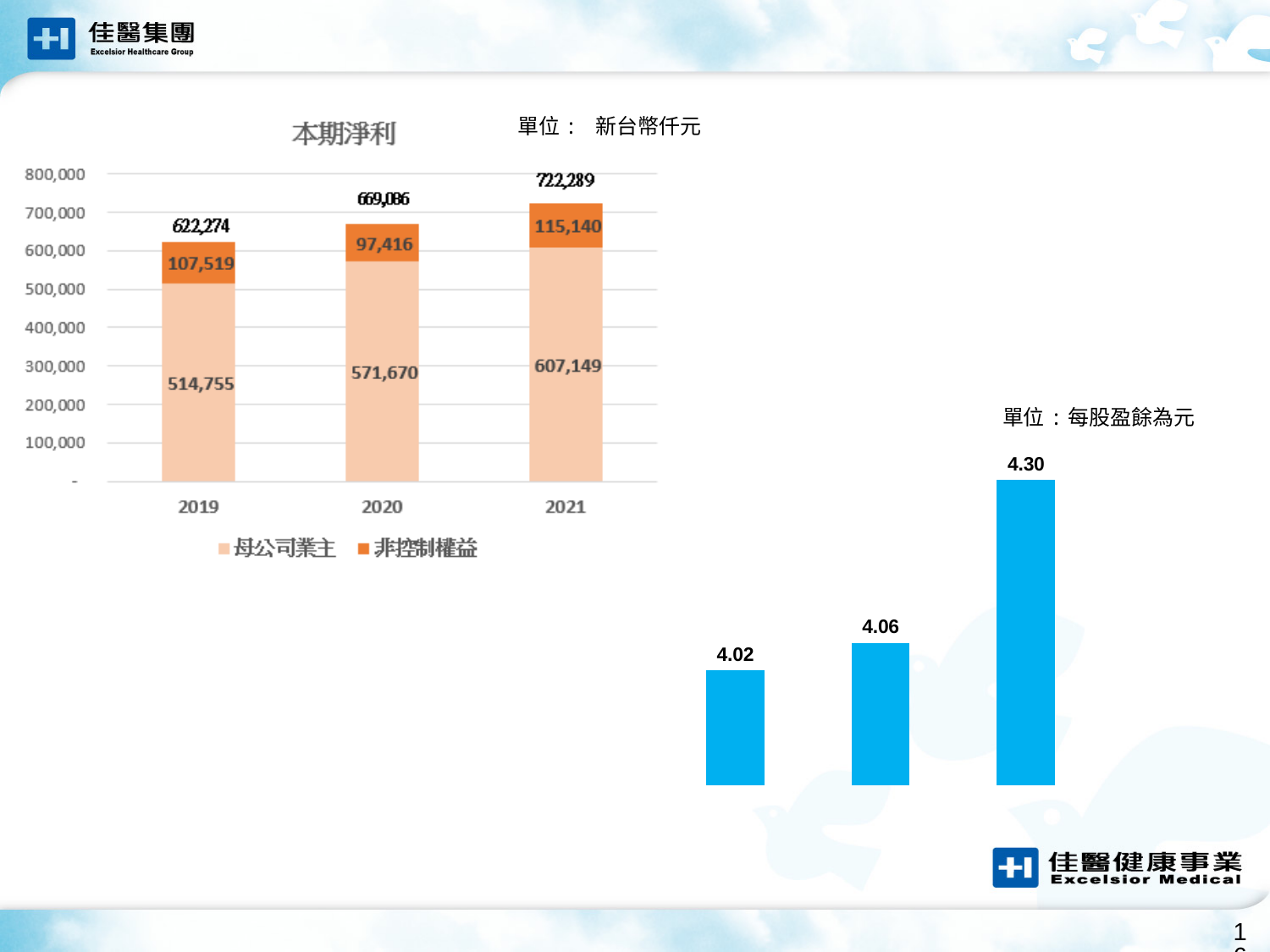
In the 本期淨利 chart on the left, which year has the lowest 非控制權益 value? 2020 In the EPS chart on the right (單位：每股盈餘為元), what is the highest value shown? 4.30 In the 本期淨利 chart on the left, how many series does the legend list? 2 In the 本期淨利 chart on the left, which year has the highest total net profit? 2021 In the 本期淨利 chart on the left, what is the total of the stacked bar for 2020? 669,086 In the 本期淨利 chart on the left, what is the value of 母公司業主 for 2021? 607,149 In the 本期淨利 chart on the left, what is the difference between the 母公司業主 values for 2020 and 2019? 56,915 In the EPS chart on the right (單位：每股盈餘為元), do the values rise or fall from left to right? Rise In the 本期淨利 chart on the left, what is the value of 非控制權益 for 2019? 107,519 In the 本期淨利 chart on the left, is the 非控制權益 value larger in 2021 or in 2020? 2021 What kind of chart is the 本期淨利 chart on the left? Stacked bar chart In the 本期淨利 chart on the left, how many years are shown on the x axis? 3